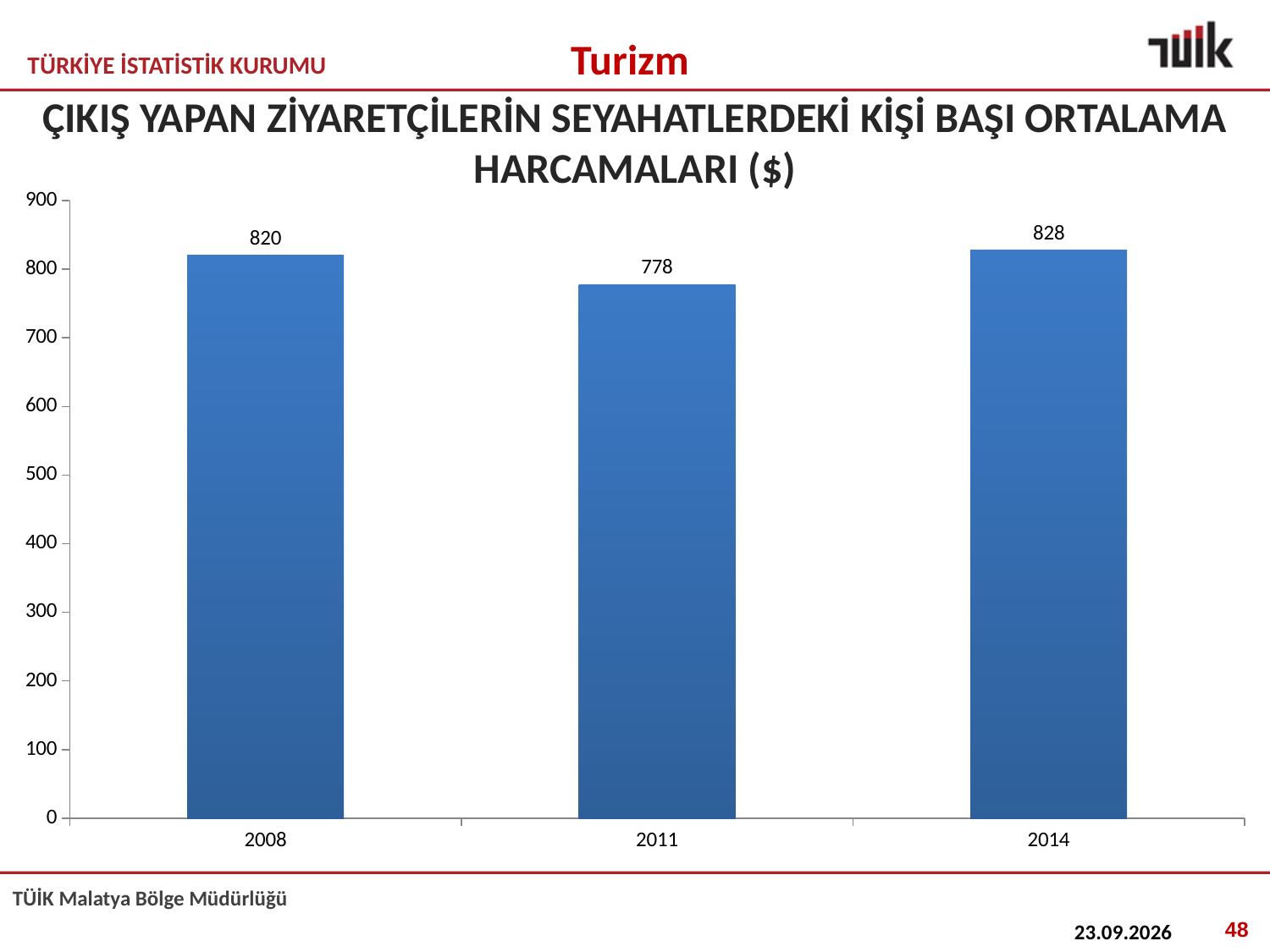
What is the value shown for 2011? 778 What is the title of the chart? ÇIKIŞ YAPAN ZİYARETÇİLERİN SEYAHATLERDEKİ KİŞİ BAŞI ORTALAMA HARCAMALARI ($) How many years are shown on the x axis? 3 What is the average per-person spending value shown for 2008? 820 Is the value for 2011 greater or less than 800? less What is the difference between the values for 2008 and 2011? 42 What is the value shown for 2014? 828 What kind of chart is shown on the slide? bar chart Which year has the highest value? 2014 What is the difference between the values for 2014 and 2011? 50 Which is larger, the value for 2008 or the value for 2011? 2008 Which year has the lowest value? 2011